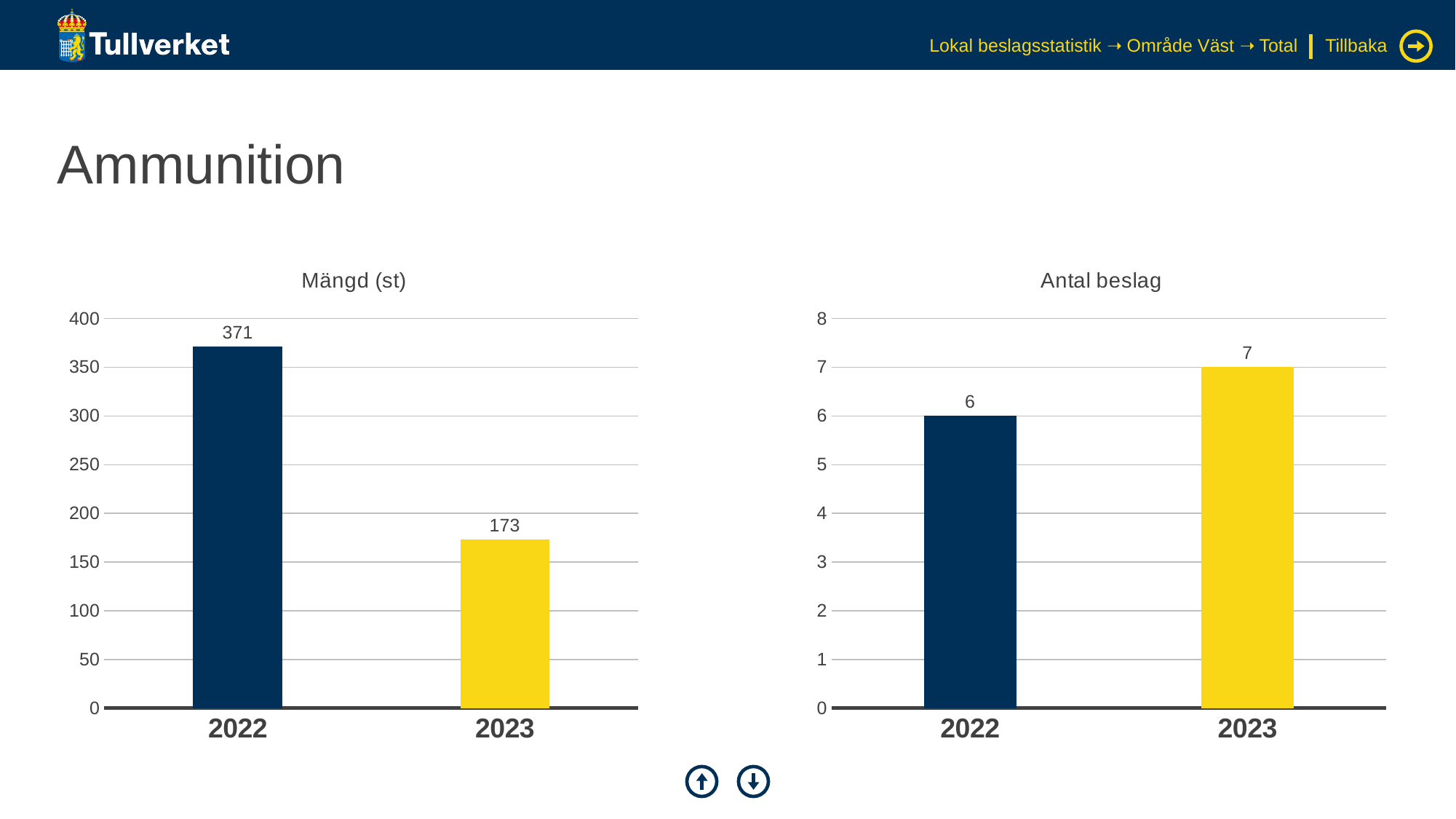
In the 'Mängd (st)' chart, what is the difference between the 2022 and 2023 values? 198 In the 'Antal beslag' chart, what is the value for 2022? 6 In the 'Antal beslag' chart, what is the difference between the 2023 and 2022 values? 1 In the 'Antal beslag' chart, what is the value for 2023? 7 How many categories are shown in the 'Antal beslag' chart? 2 In the 'Antal beslag' chart, is the value for 2023 larger than the value for 2022? Yes In the 'Mängd (st)' chart, do the values rise or fall from 2022 to 2023? Fall In the 'Antal beslag' chart, which year has the lowest value? 2022 In the 'Mängd (st)' chart, what is the value for 2023? 173 What kind of chart is the 'Mängd (st)' chart? Bar chart In the 'Mängd (st)' chart, which year has the highest value? 2022 In the 'Mängd (st)' chart, what is the value for 2022? 371